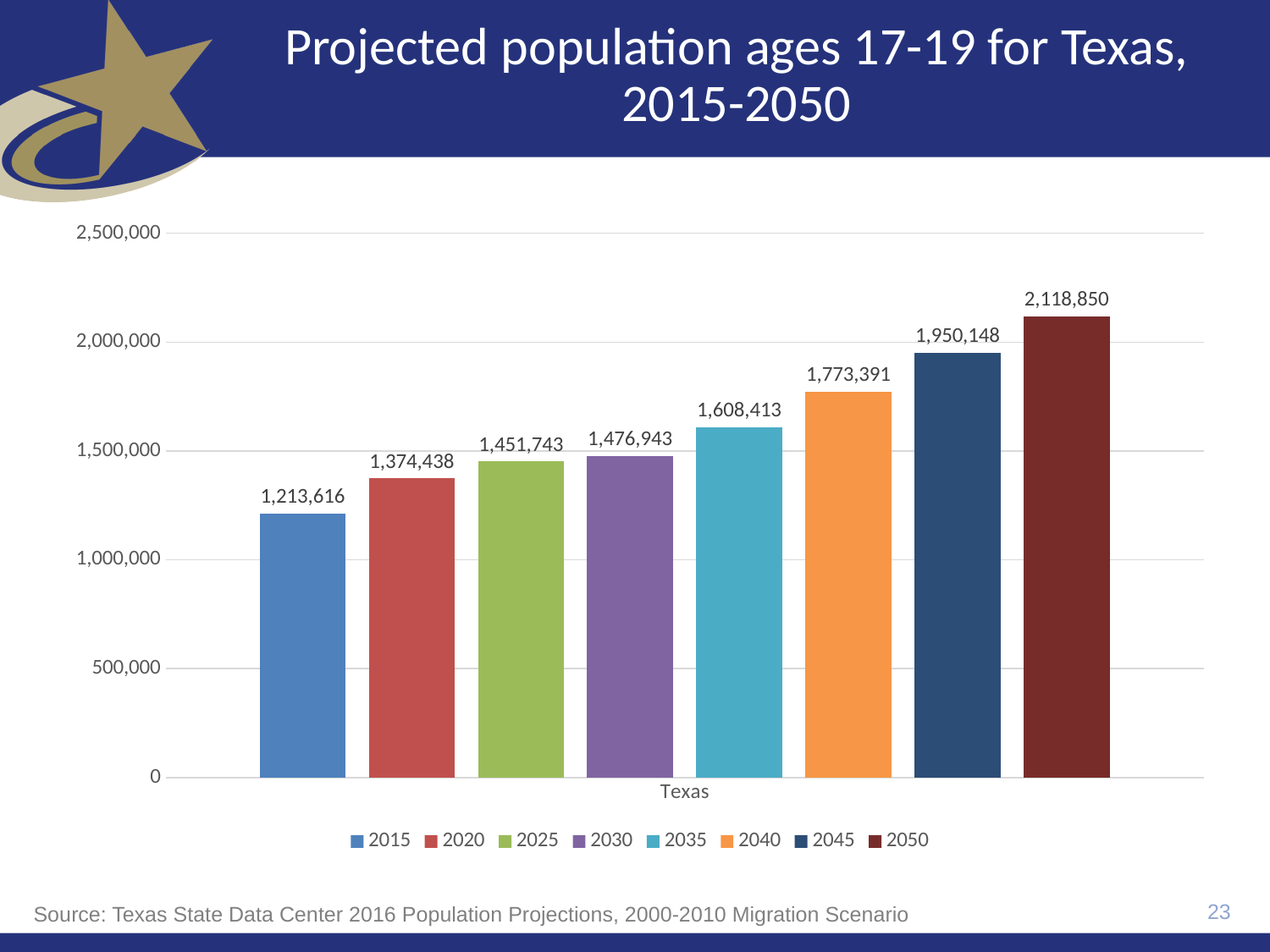
Which is larger, the projected population ages 17-19 in 2030 or in 2040? 2040 What is the projected population ages 17-19 for Texas in 2015? 1,213,616 What is the difference between the projected population ages 17-19 in 2050 and in 2015? 905,234 What kind of chart is shown on the slide? bar chart Do the projected population values rise or fall from 2015 to 2050? rise Which year has the highest projected population ages 17-19 for Texas? 2050 What is the projected population ages 17-19 for Texas in 2050? 2,118,850 Which year has the lowest projected population ages 17-19 for Texas? 2015 How many series does the legend list? 8 Is the projected population ages 17-19 for Texas in 2045 greater or less than 2,000,000? less What is the difference between the projected population ages 17-19 in 2045 and in 2040? 176,757 What is the projected population ages 17-19 for Texas in 2035? 1,608,413